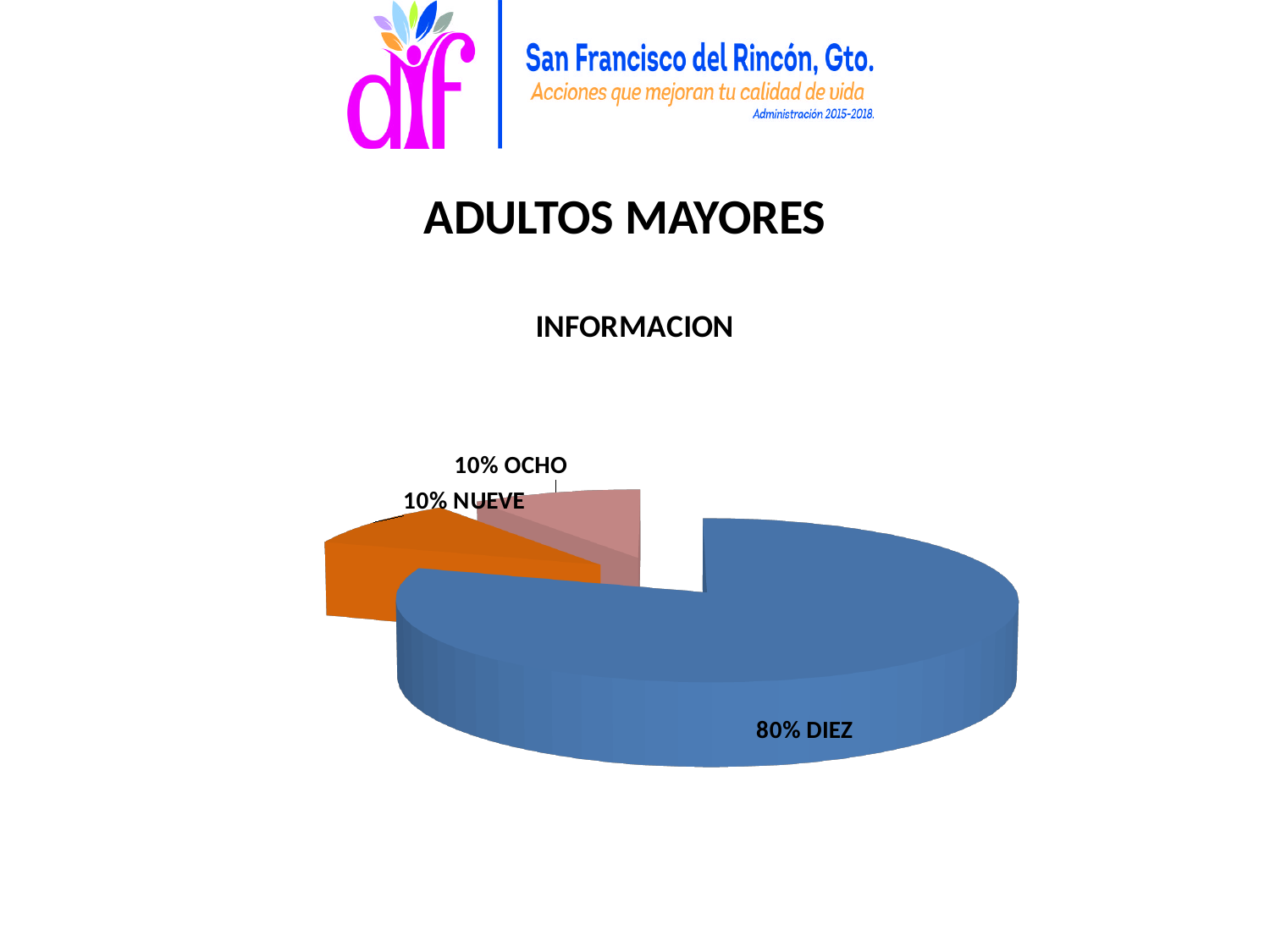
What is the difference in percentage points between the DIEZ slice and the OCHO slice? 70 What share of the pie does DIEZ represent? 80% What is the title of the chart? INFORMACION Which category has the largest slice of the pie? DIEZ What share of the pie does NUEVE represent? 10% What share of the pie does OCHO represent? 10% How many slices does the pie chart have? 3 What kind of chart is shown on the slide? pie chart What colour is the DIEZ slice? blue Which is larger, the DIEZ slice or the NUEVE slice? DIEZ What is the combined share of the OCHO and NUEVE slices? 20%